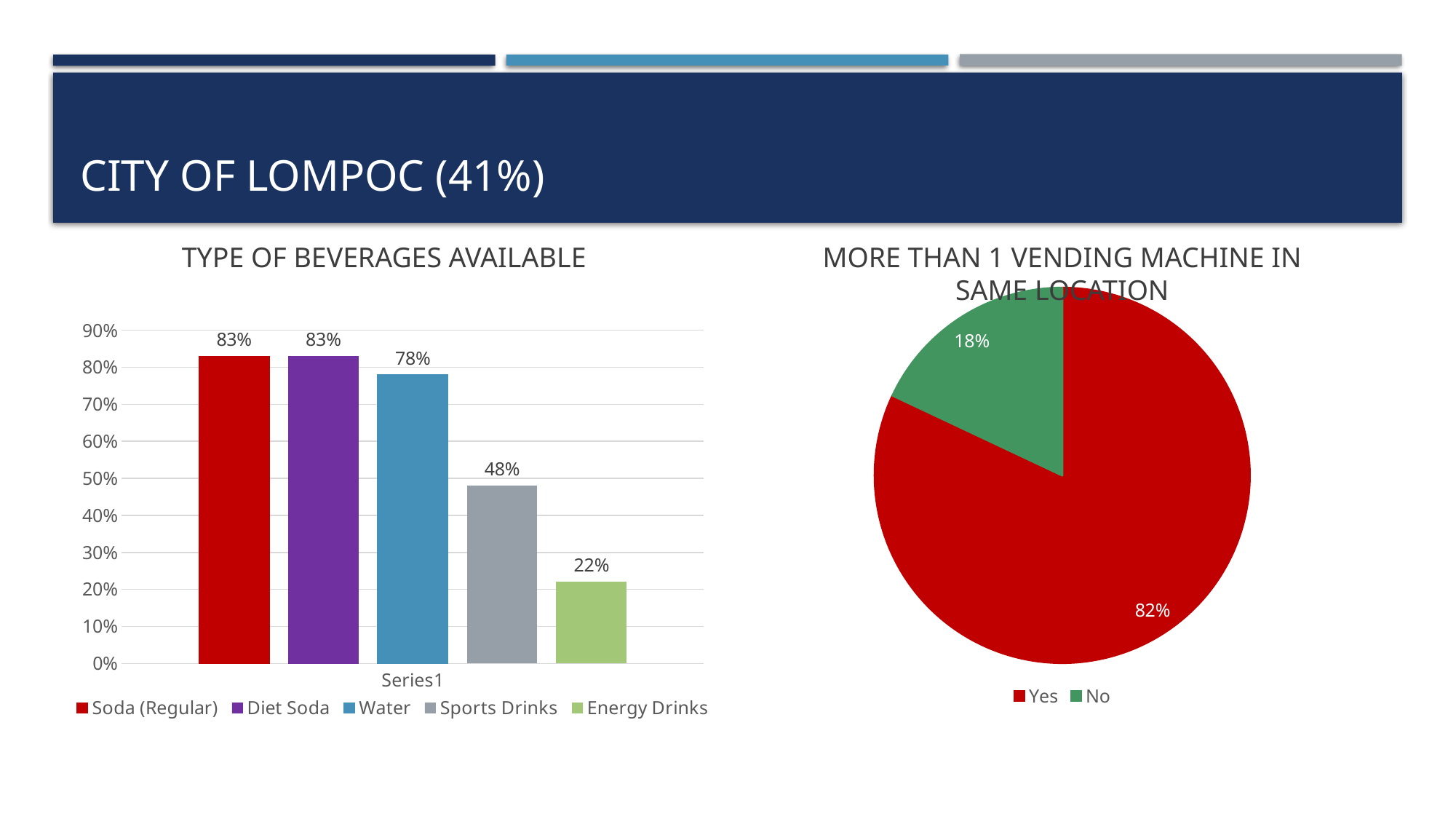
In the 'Type of Beverages Available' chart, what is the difference between the values for Water and Sports Drinks? 30% In the 'Type of Beverages Available' chart, what is the value for Sports Drinks? 48% In the 'More Than 1 Vending Machine in Same Location' chart, what share of the pie is 'Yes'? 82% In the 'Type of Beverages Available' chart, which is larger, the value for Sports Drinks or the value for Energy Drinks? Sports Drinks In the 'Type of Beverages Available' chart, what is the value for Energy Drinks? 22% In the 'More Than 1 Vending Machine in Same Location' chart, how many entries does the legend list? 2 In the 'Type of Beverages Available' chart, which beverage has the lowest value? Energy Drinks In the 'More Than 1 Vending Machine in Same Location' chart, what is the value for 'No'? 18% What kind of chart is the 'Type of Beverages Available' chart? Bar chart What kind of chart is the 'More Than 1 Vending Machine in Same Location' chart? Pie chart In the 'Type of Beverages Available' chart, how many beverage types are plotted? 5 In the 'Type of Beverages Available' chart, what is the value for Water? 78%